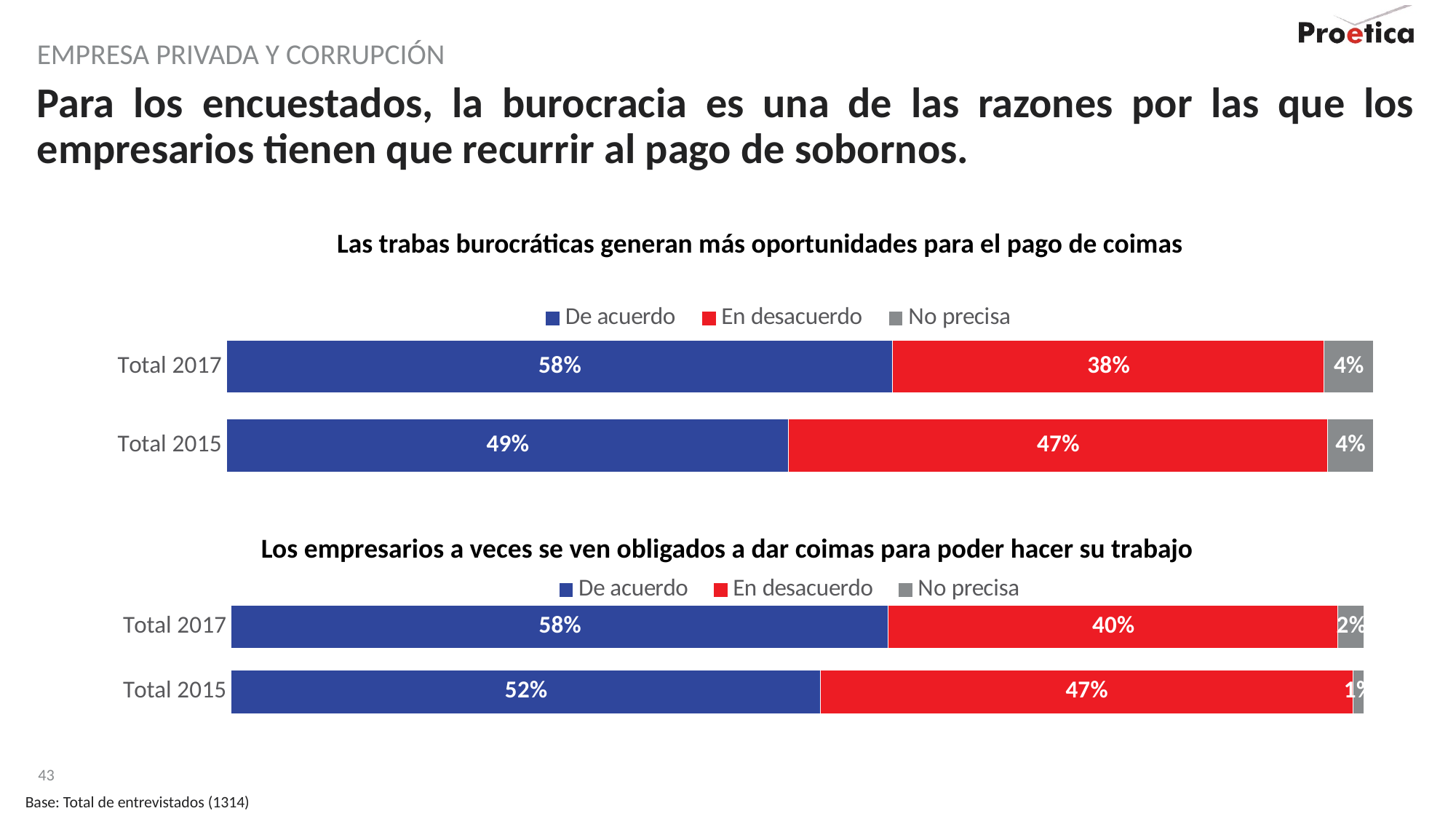
In the chart 'Las trabas burocráticas generan más oportunidades para el pago de coimas', what is the 'De acuerdo' value for Total 2017? 58% In the chart 'Las trabas burocráticas generan más oportunidades para el pago de coimas', what is the difference between the 'De acuerdo' values for Total 2017 and Total 2015? 9 percentage points In the chart 'Las trabas burocráticas generan más oportunidades para el pago de coimas', what is the 'No precisa' value for Total 2017? 4% What kind of chart is 'Los empresarios a veces se ven obligados a dar coimas para poder hacer su trabajo'? Stacked bar chart In the chart 'Los empresarios a veces se ven obligados a dar coimas para poder hacer su trabajo', what is the 'En desacuerdo' value for Total 2017? 40% In the chart 'Las trabas burocráticas generan más oportunidades para el pago de coimas', what colour represents 'En desacuerdo'? Red How many categories are shown in the chart 'Las trabas burocráticas generan más oportunidades para el pago de coimas'? 2 In the chart 'Los empresarios a veces se ven obligados a dar coimas para poder hacer su trabajo', which is larger for Total 2015: 'De acuerdo' or 'En desacuerdo'? De acuerdo In the chart 'Los empresarios a veces se ven obligados a dar coimas para poder hacer su trabajo', what is the 'De acuerdo' value for Total 2015? 52% In the chart 'Las trabas burocráticas generan más oportunidades para el pago de coimas', what is the 'En desacuerdo' value for Total 2015? 47% In the chart 'Las trabas burocráticas generan más oportunidades para el pago de coimas', which year has the higher 'En desacuerdo' value? Total 2015 How many series does the legend list in the chart 'Los empresarios a veces se ven obligados a dar coimas para poder hacer su trabajo'? 3